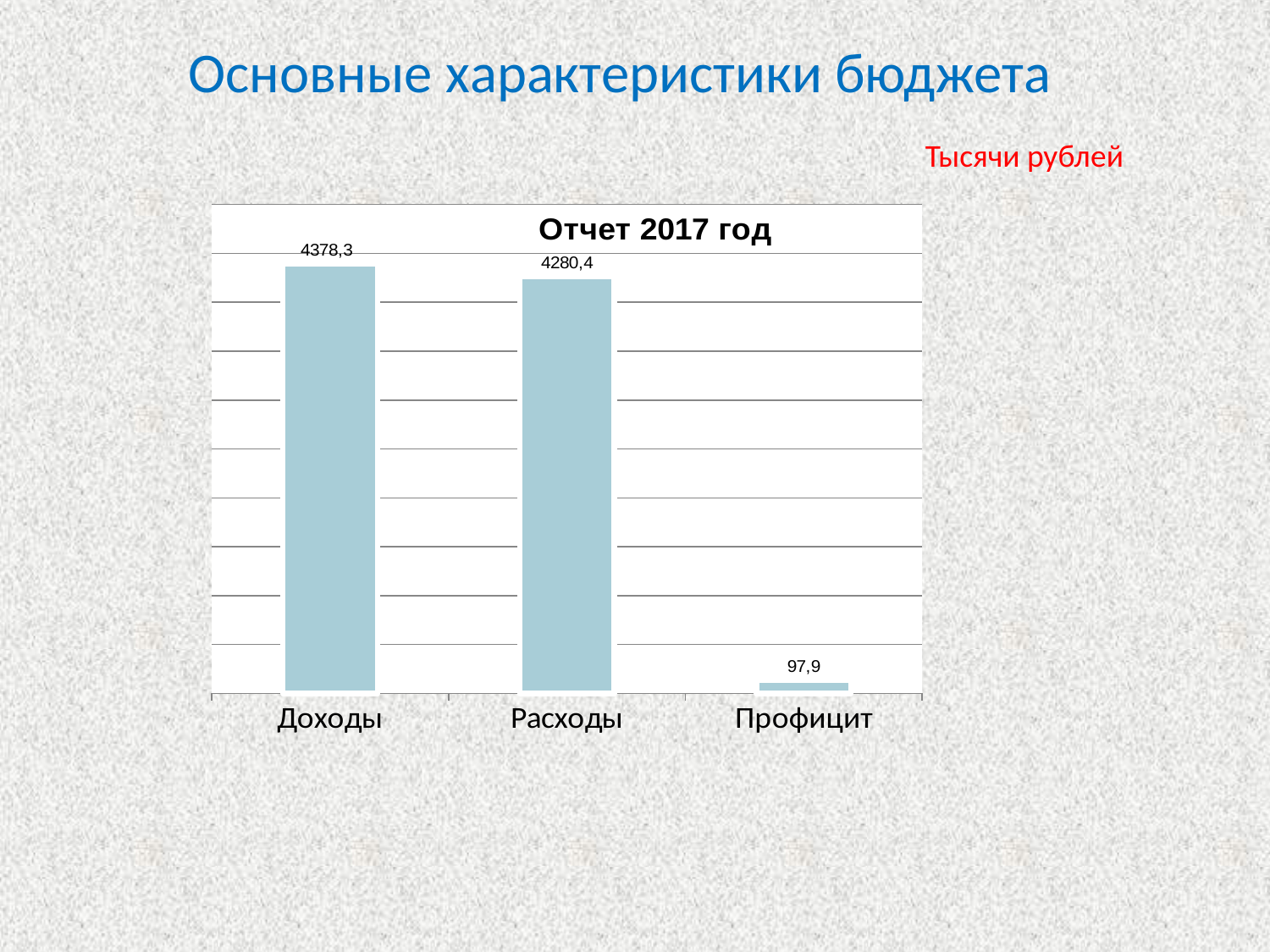
What is the title of the chart? Отчет 2017 год What is the value for Профицит? 97,9 How many categories are shown on the chart? 3 What is the difference between the values for Доходы and Расходы? 97,9 What is the value for Доходы? 4378,3 Which is larger, the value for Доходы or the value for Расходы? Доходы Which category has the lowest value? Профицит Which is larger, the value for Расходы or the value for Профицит? Расходы What is the difference between the values for Расходы and Профицит? 4182,5 Which category has the highest value? Доходы What is the value for Расходы? 4280,4 What kind of chart is shown on the slide? Bar chart